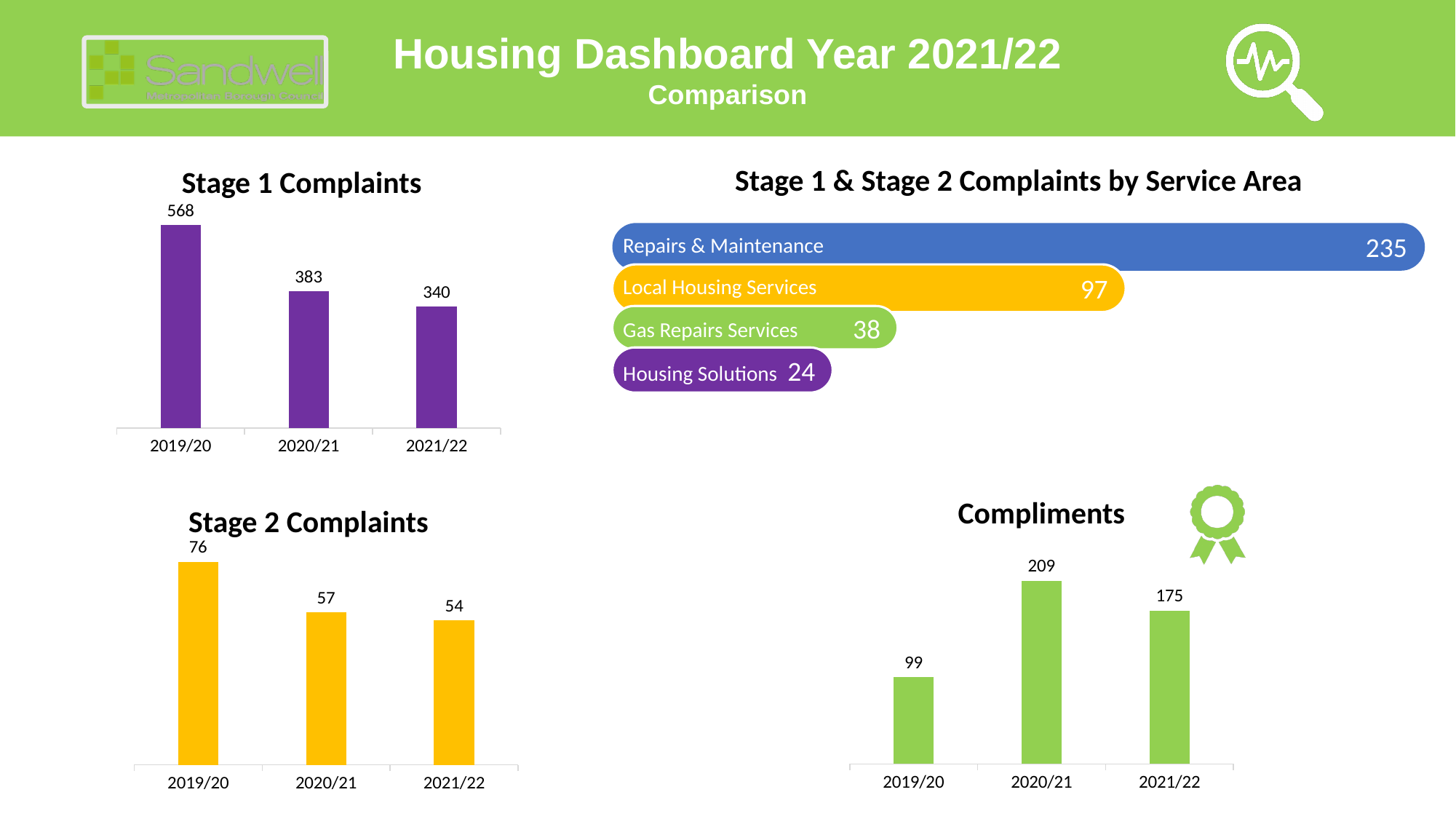
In the Stage 2 Complaints chart, which is larger, 2019/20 or 2021/22? 2019/20 What kind of chart is the Compliments chart? bar chart In the Stage 1 & Stage 2 Complaints by Service Area chart, what is the value for Local Housing Services? 97 In the Stage 1 Complaints chart, which year has the lowest value? 2021/22 In the Stage 1 & Stage 2 Complaints by Service Area chart, what is the difference between Gas Repairs Services and Housing Solutions? 14 In the Compliments chart, which year has the highest value? 2020/21 In the Stage 1 & Stage 2 Complaints by Service Area chart, which service area has the highest value? Repairs & Maintenance In the Stage 2 Complaints chart, what is the value for 2020/21? 57 In the Stage 1 Complaints chart, what is the difference between 2019/20 and 2020/21? 185 In the Stage 1 Complaints chart, do the values rise or fall from 2019/20 to 2021/22? fall In the Stage 1 & Stage 2 Complaints by Service Area chart, how many service areas are shown? 4 In the Stage 1 Complaints chart, what is the value for 2019/20? 568